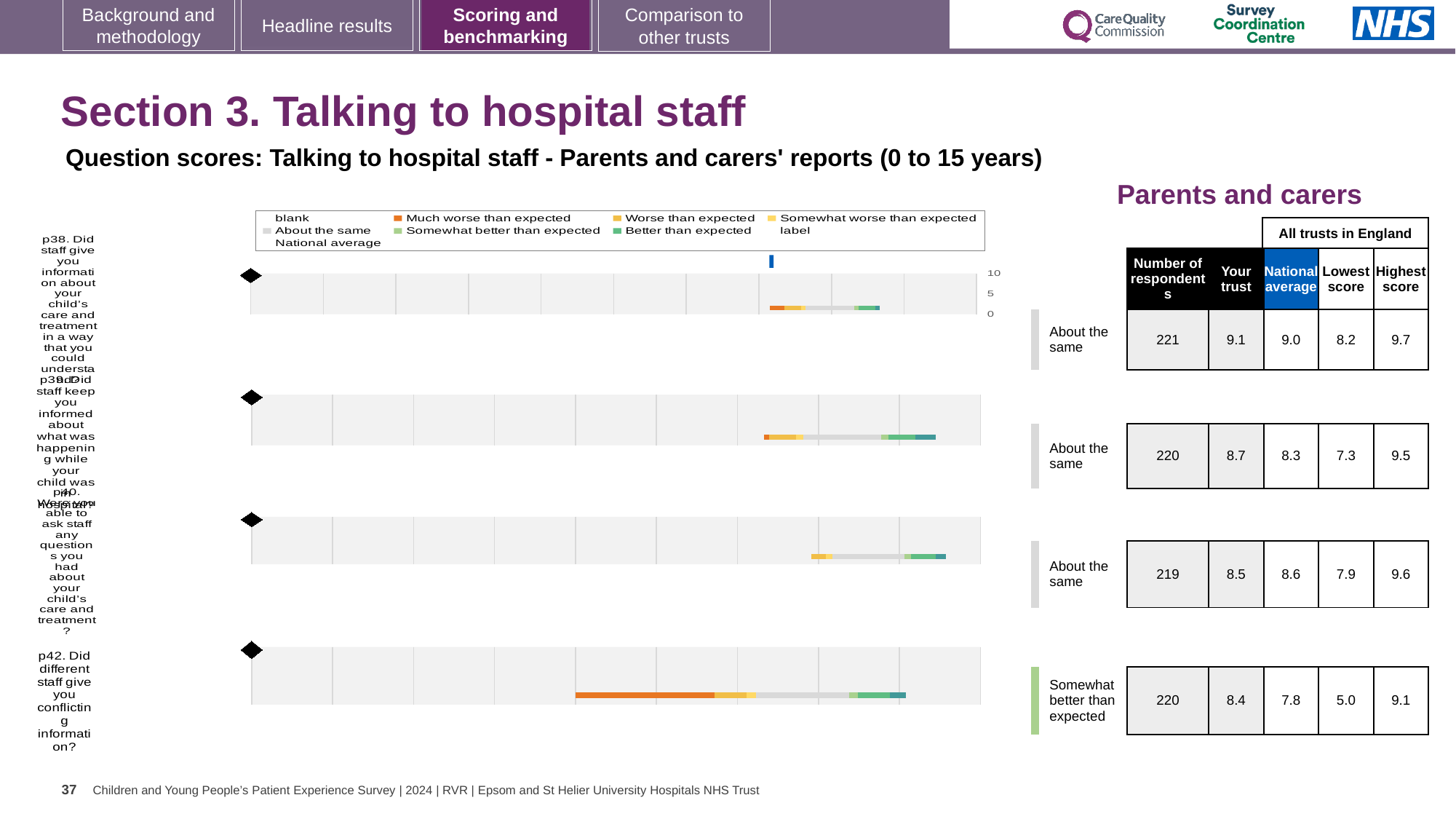
Which legend entry is shown in orange? Much worse than expected For the p40 chart (able to ask staff any questions), what is the number of respondents? 219 How many question charts (rows) are shown on the slide? 4 Which question chart has the lowest 'Your trust' score? p42 For the p38 chart (information about your child's care and treatment), what is the 'Your trust' score? 9.1 For the p42 chart (different staff giving conflicting information), what is the lowest score among all trusts in England? 5.0 For the p39 chart (staff keeping you informed), what is the national average score? 8.3 Which question chart has the highest 'Your trust' score? p38 How many entries does the legend at the top of the charts list? 9 For the p42 chart, what is the difference between the 'Your trust' score and the national average? 0.6 What kind of chart is used for each question row on the slide? Bar chart For the p40 chart, which is larger: the 'Your trust' score or the national average? National average